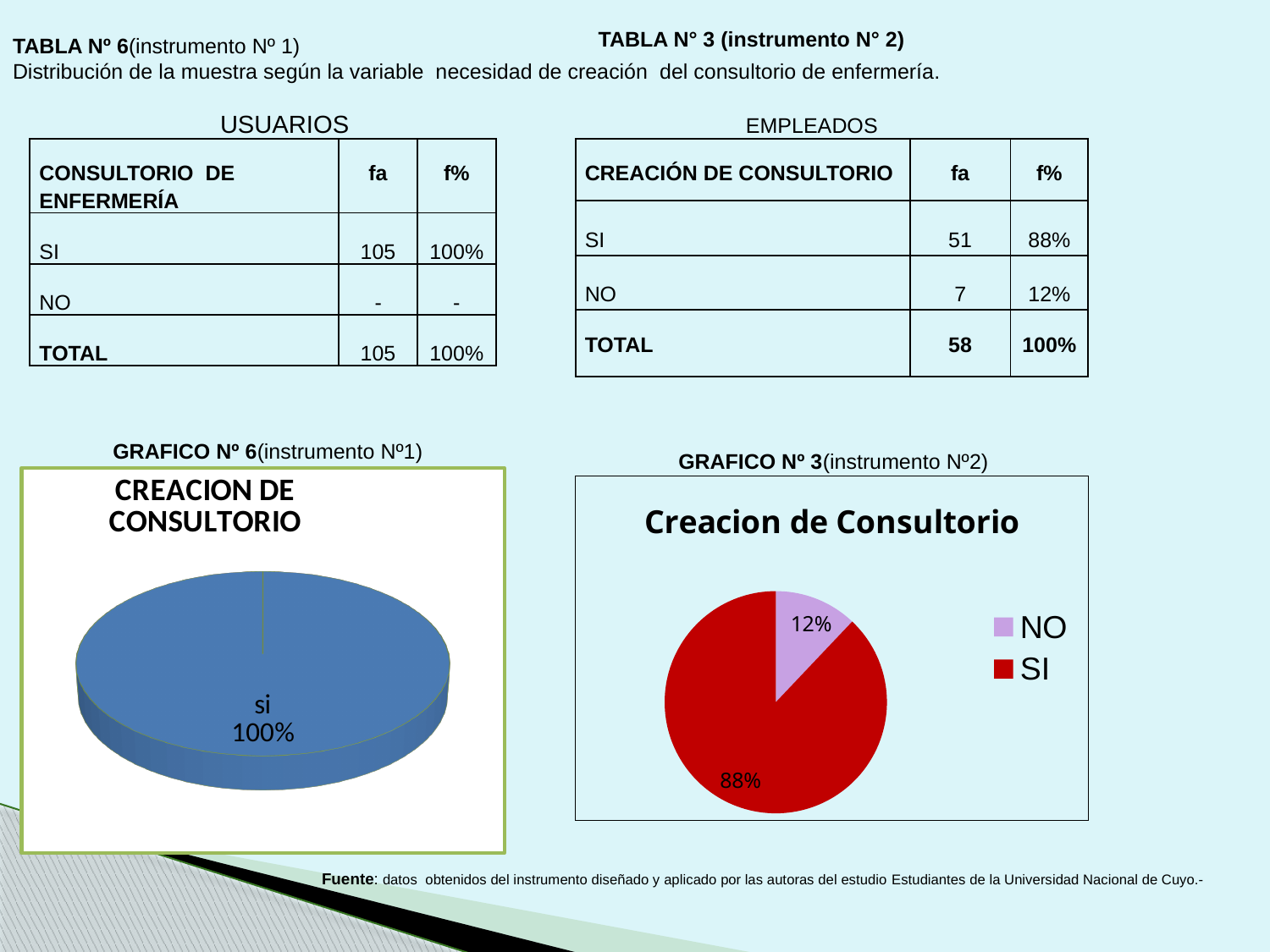
In the left-hand pie chart titled "CREACION DE CONSULTORIO", what percentage is shown for the "si" slice? 100% In the right-hand pie chart titled "Creacion de Consultorio", what is the difference in percentage points between SI and NO? 76 In the right-hand pie chart titled "Creacion de Consultorio", what percentage is shown for SI? 88% In the right-hand pie chart titled "Creacion de Consultorio", which category has the smallest slice? NO In the right-hand pie chart titled "Creacion de Consultorio", what percentage is shown for NO? 12% How many slices does the left-hand pie chart titled "CREACION DE CONSULTORIO" show? 1 What type of chart is the right-hand chart titled "Creacion de Consultorio"? Pie chart In the right-hand pie chart titled "Creacion de Consultorio", what colour is the SI slice? Red In the right-hand pie chart titled "Creacion de Consultorio", which is larger, the SI slice or the NO slice? SI How many categories does the legend of the right-hand pie chart titled "Creacion de Consultorio" list? 2 What type of chart is the left-hand chart titled "CREACION DE CONSULTORIO"? Pie chart In the right-hand pie chart titled "Creacion de Consultorio", which category has the largest slice? SI